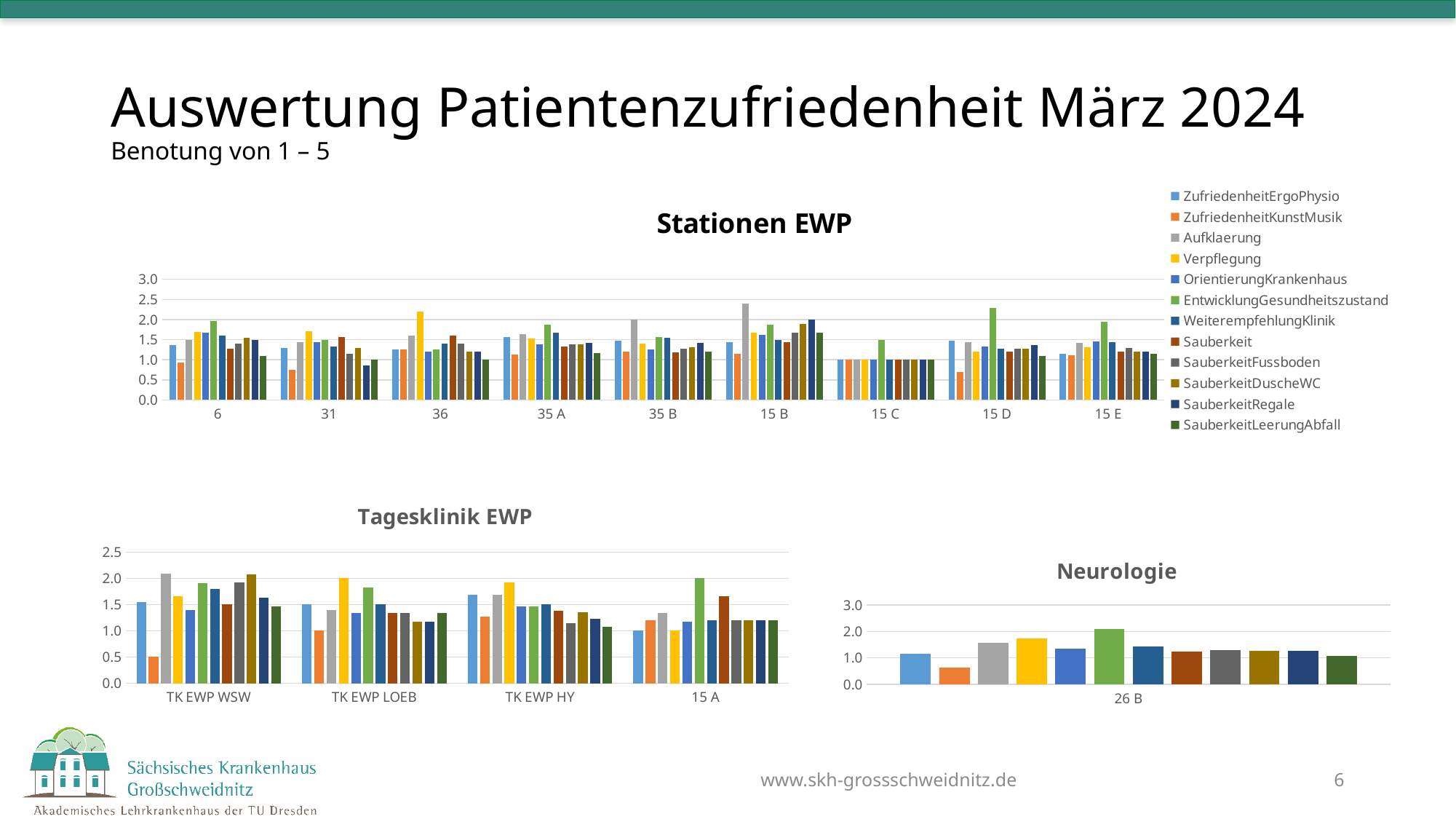
In the "Stationen EWP" chart, is the value of Aufklaerung for 15 B greater or less than 2.0? greater In the "Tagesklinik EWP" chart, which series has the highest value for 15 A? EntwicklungGesundheitszustand In the "Stationen EWP" chart, which is larger: Aufklaerung for 15 B or Aufklaerung for 15 C? Aufklaerung for 15 B In the "Tagesklinik EWP" chart, is the value of ZufriedenheitKunstMusik for TK EWP WSW greater or less than 1.0? less How many categories are shown on the x axis of the "Stationen EWP" chart? 9 In the "Stationen EWP" chart, is the value of Verpflegung for 36 greater or less than 2.0? greater How many categories are shown on the x axis of the "Tagesklinik EWP" chart? 4 Which category is shown on the x axis of the "Neurologie" chart? 26 B What kind of chart is the "Stationen EWP" chart? bar chart In the "Neurologie" chart, which series has the lowest value for 26 B? ZufriedenheitKunstMusik In the "Neurologie" chart, which series has the highest value for 26 B? EntwicklungGesundheitszustand How many series does the legend on the slide list? 12